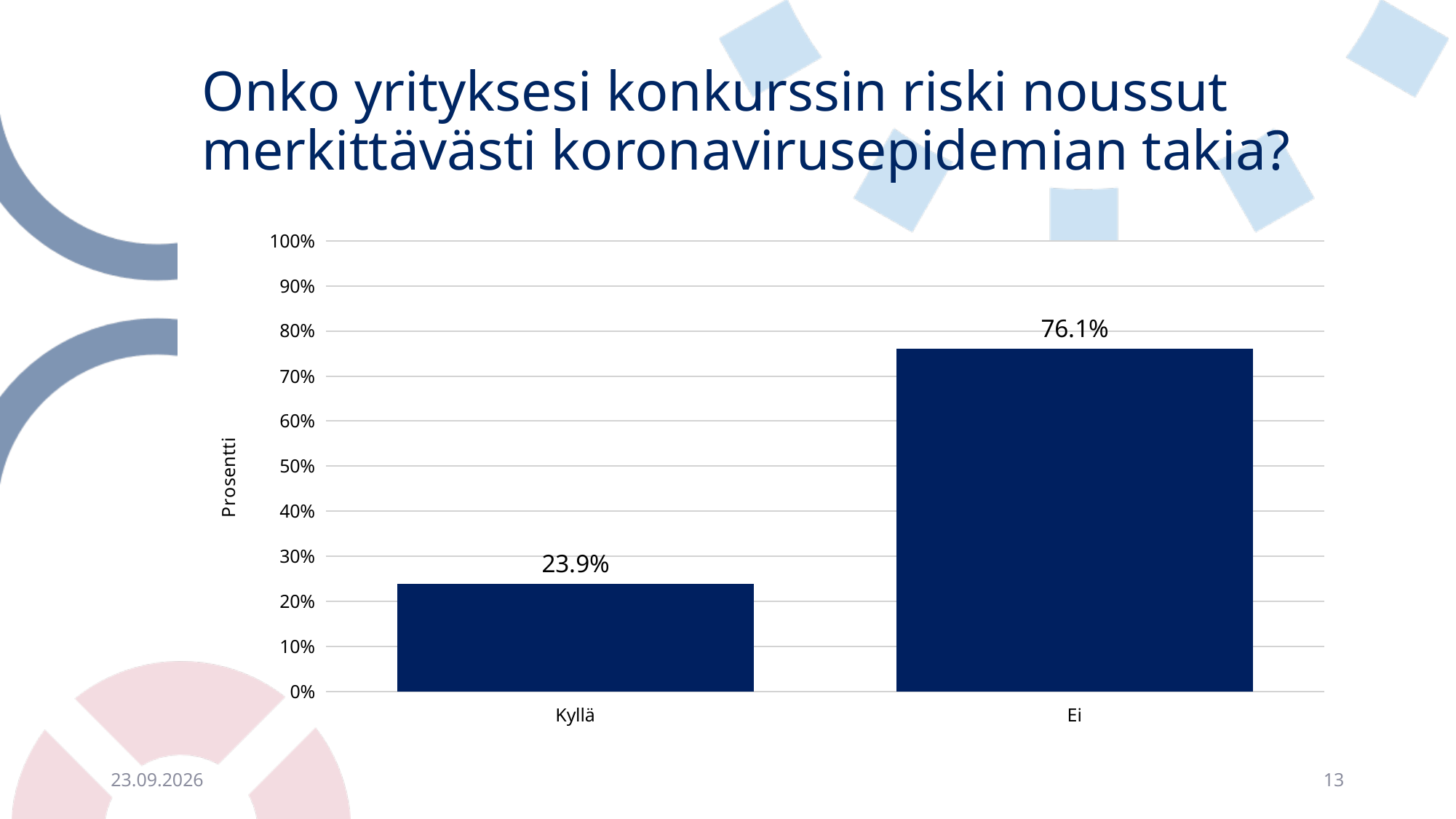
Which category has the lowest value? Kyllä What kind of chart is shown on the slide? bar chart Which is larger, the value for Kyllä or the value for Ei? Ei What is the label of the vertical axis? Prosentti How many categories are shown on the x axis? 2 What is the difference between the values for Ei and Kyllä? 52.2% What is the highest value shown on the vertical axis? 100% Is the value for Ei greater or less than 70%? greater What is the value for Kyllä? 23.9% Which category has the highest value? Ei What is the value for Ei? 76.1% Is the value for Kyllä greater or less than 30%? less